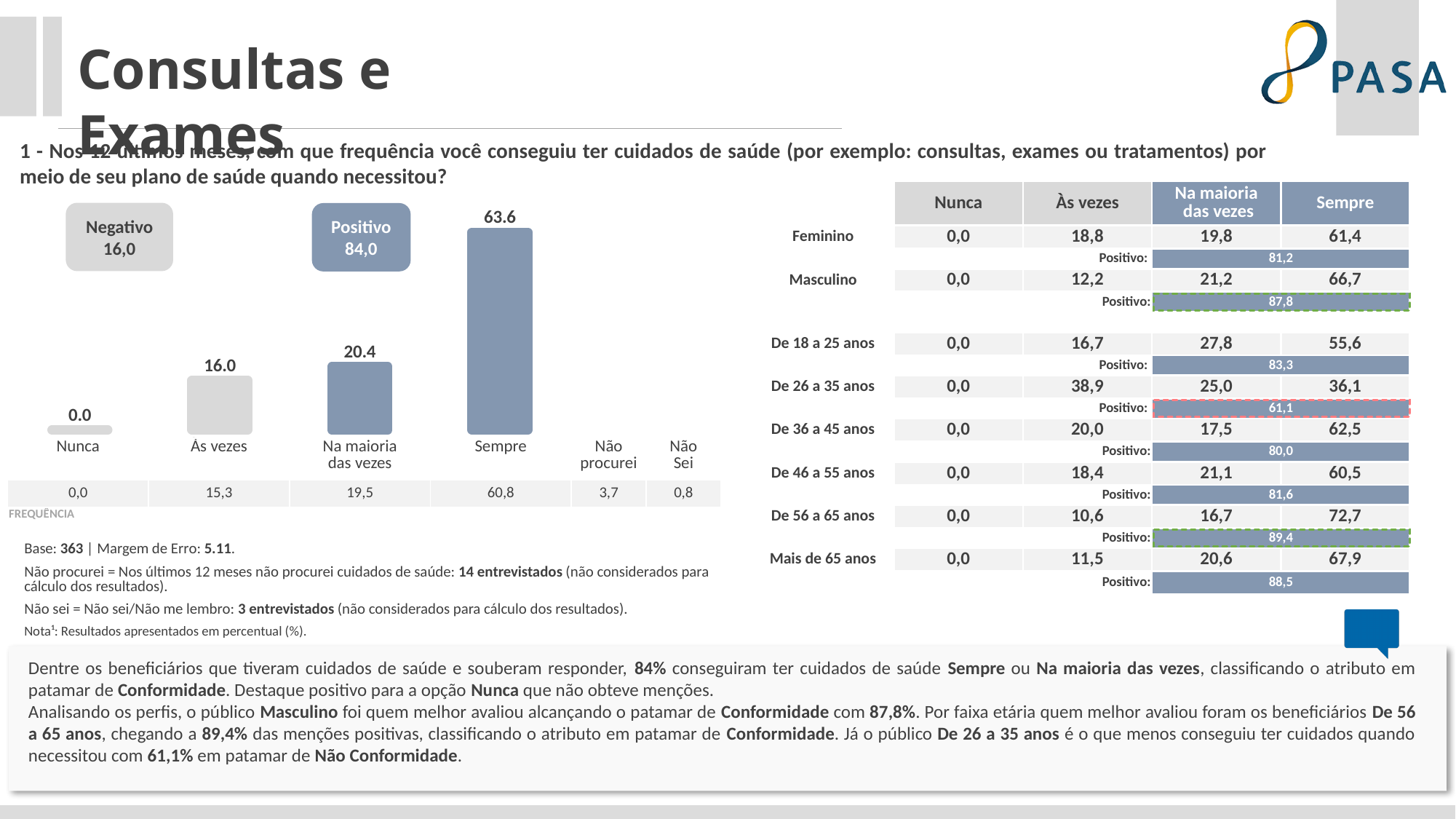
What is the difference between the values for Na maioria das vezes and Às vezes in the bar chart? 4.4 Which is larger in the bar chart, the value for Às vezes or the value for Na maioria das vezes? Na maioria das vezes What kind of chart is shown on the left of the slide? bar chart How many categories in the bar chart have a value greater than 10? 3 What is the value for Na maioria das vezes in the bar chart? 20.4 Which category has the lowest value in the bar chart? Nunca What is the value for Sempre in the bar chart? 63.6 What is the value for Às vezes in the bar chart? 16.0 What is the difference between the values for Sempre and Na maioria das vezes in the bar chart? 43.2 What is the value for Nunca in the bar chart? 0.0 What value is shown in the Positivo box above the bar chart? 84,0 Which category has the highest value in the bar chart? Sempre